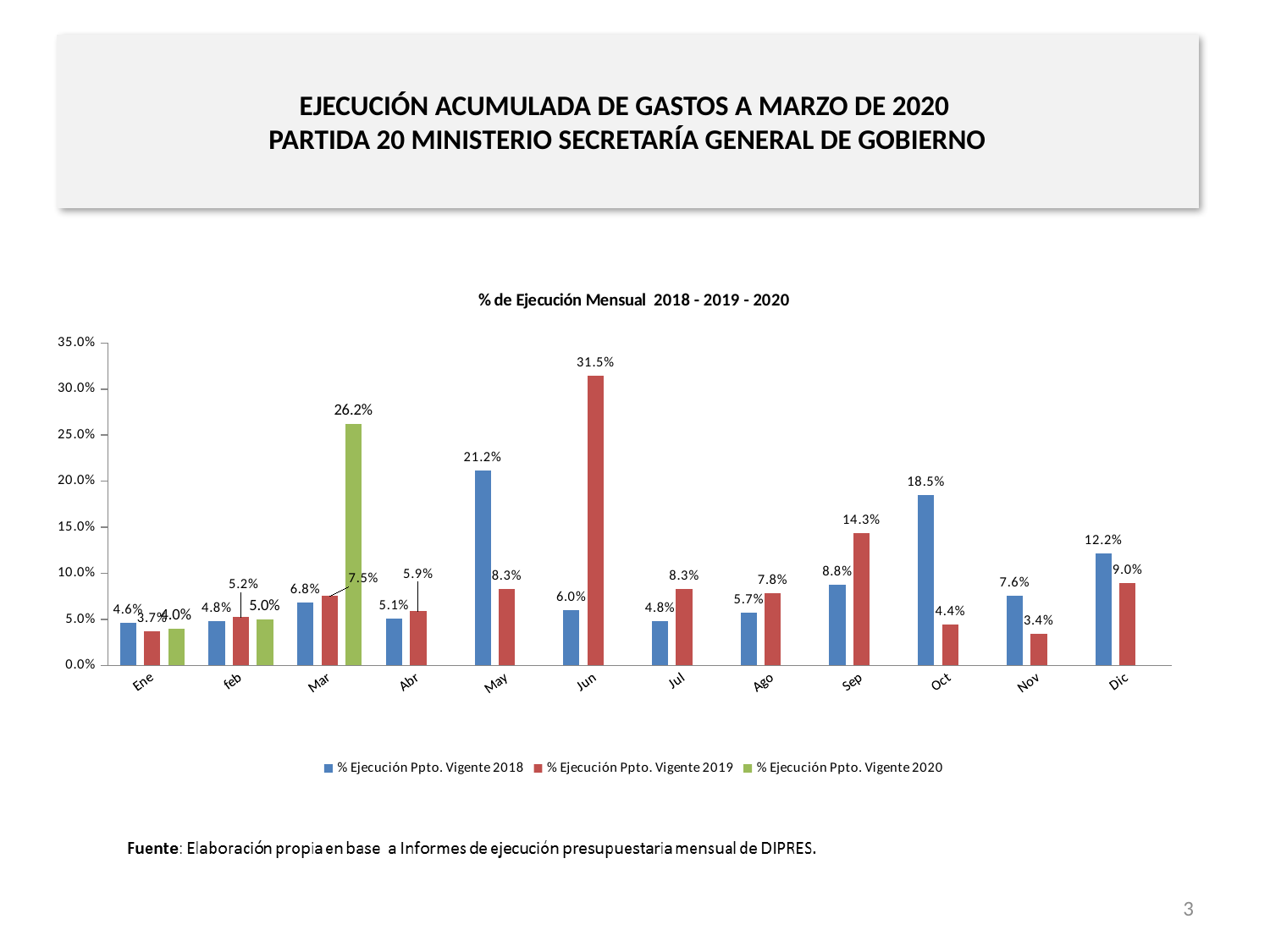
What is the value for % Ejecución Ppto. Vigente 2019 in Jun? 31.5% In which month is the % Ejecución Ppto. Vigente 2018 value highest? May Which is larger in Dic, the 2018 value or the 2019 value? 2018 value (12.2%) How many months are shown on the x axis? 12 What is the value for % Ejecución Ppto. Vigente 2020 in Mar? 26.2% What is the difference between the 2019 and 2018 values in Sep? 5.5% What type of chart is shown on the slide? bar chart In which month is the % Ejecución Ppto. Vigente 2019 value lowest? Nov Is the value for % Ejecución Ppto. Vigente 2019 in Jun greater or less than 30.0%? greater What is the value for % Ejecución Ppto. Vigente 2018 in Oct? 18.5% How many series does the legend list? 3 What is the title of the chart? % de Ejecución Mensual 2018 - 2019 - 2020